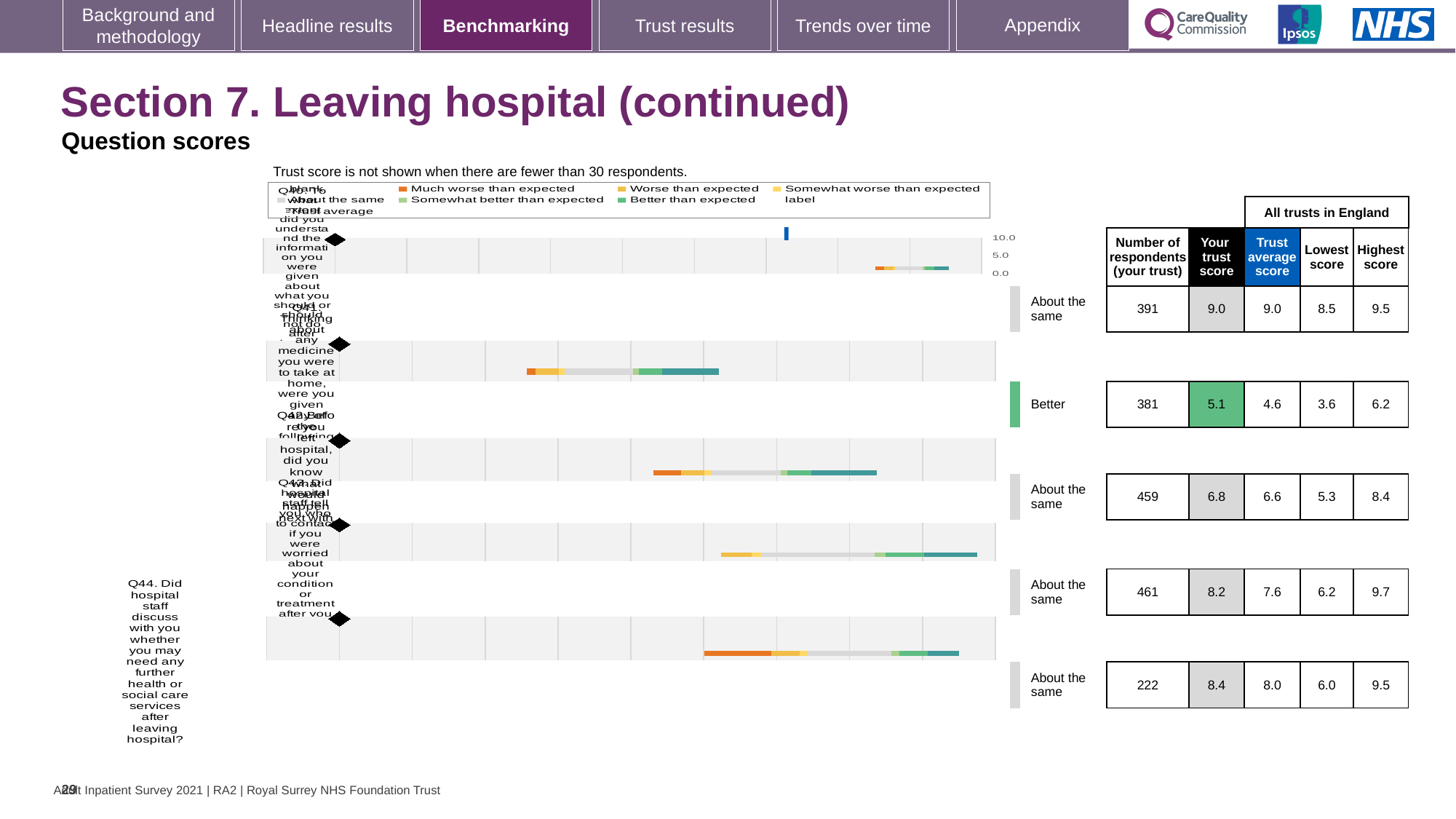
How many question rows are shown in the benchmarking chart and table? 5 What is the highest 'Your trust score' value shown in the table? 9.0 For Q44, what is the trust average score across all trusts in England? 8.0 For Q44 (discussing further health or social care services after leaving hospital), what is the number of respondents for your trust? 222 How many of the question rows are rated 'About the same'? 4 For Q44, what is the difference between the highest score and the lowest score? 3.5 For Q44, what is your trust score? 8.4 For Q44, which is larger: your trust score or the trust average score? Your trust score What kind of chart is used to show the benchmarking results on this slide? bar chart What is the lowest 'Your trust score' value shown in the table? 5.1 For Q44, what is the highest score among all trusts in England? 9.5 What is the number of respondents for the question row rated 'Better'? 381